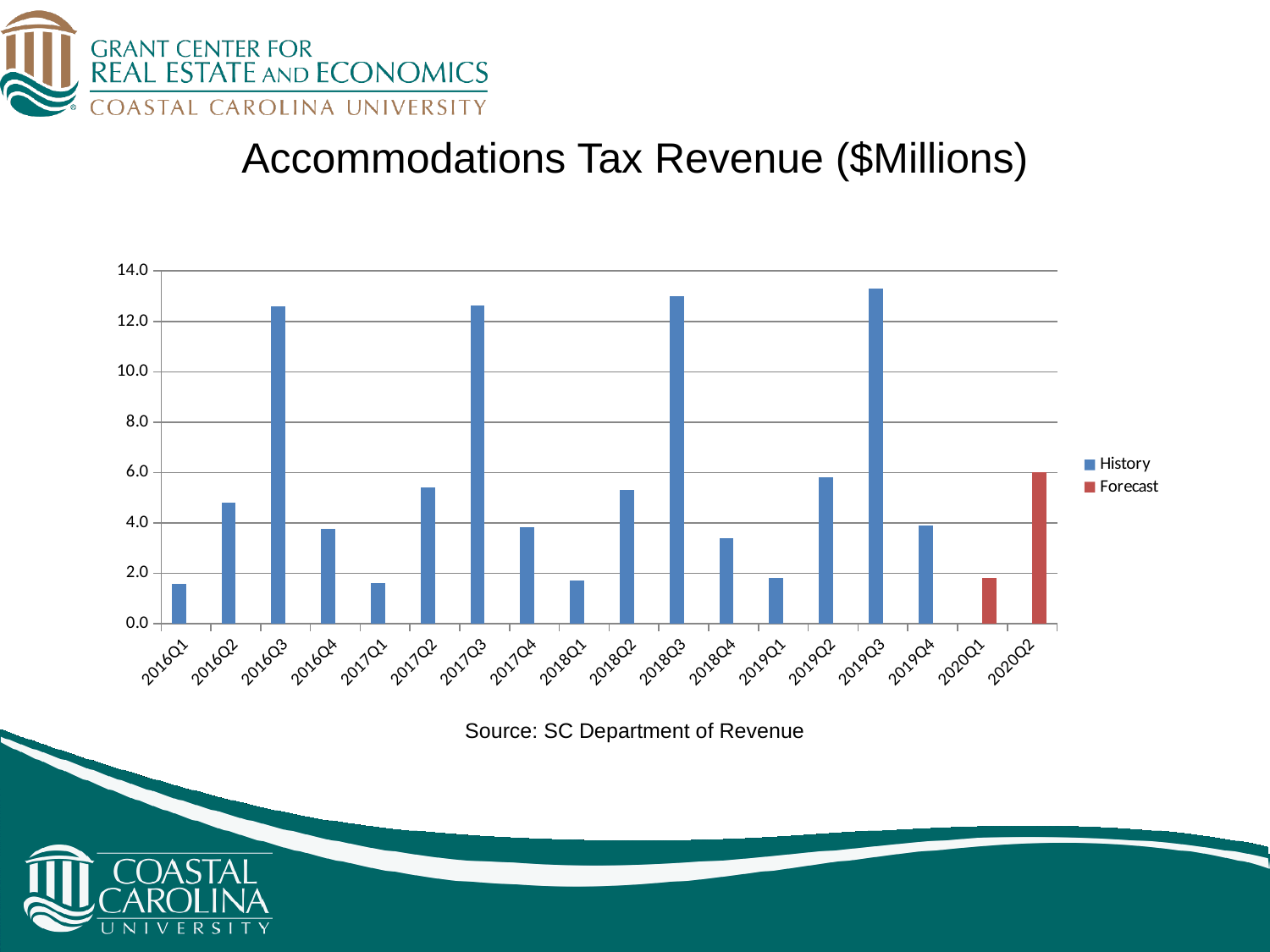
Which is larger, the value for 2016Q3 or the value for 2016Q4? 2016Q3 How many series does the legend list? 2 What kind of chart is shown on the slide? Bar chart Is the value for 2017Q2 greater or less than 4.0? greater Is the value for 2016Q2 greater or less than 4.0? greater Which quarters belong to the Forecast series? 2020Q1 and 2020Q2 Is the value for 2020Q1 greater or less than 2.0? less Which is larger, the value for 2020Q2 or the value for 2020Q1? 2020Q2 Which series is shown in red? Forecast How many quarters are plotted along the x axis? 18